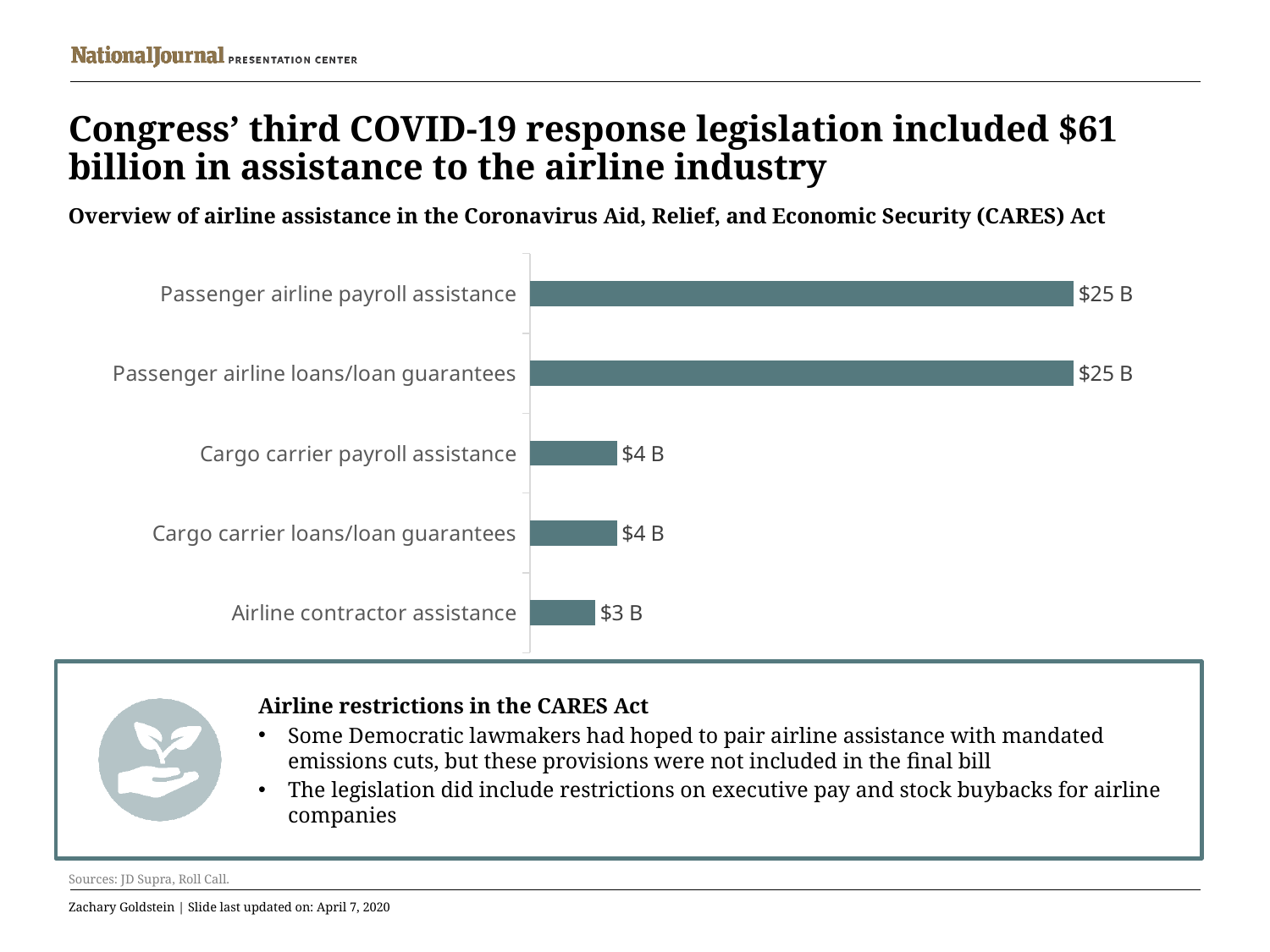
What is the value for Airline contractor assistance? $3 B Which category has the lowest value? Airline contractor assistance What kind of chart is shown on the slide? Bar chart What is the value for Cargo carrier payroll assistance? $4 B What is the subtitle of the chart? Overview of airline assistance in the Coronavirus Aid, Relief, and Economic Security (CARES) Act What is the value for Passenger airline loans/loan guarantees? $25 B What is the difference between Cargo carrier loans/loan guarantees and Airline contractor assistance? $1 B Which is larger, Cargo carrier payroll assistance or Airline contractor assistance? Cargo carrier payroll assistance What is the difference between Passenger airline payroll assistance and Cargo carrier payroll assistance? $21 B How many categories are shown in the chart? 5 What is the value for Passenger airline payroll assistance? $25 B Which is larger, Passenger airline loans/loan guarantees or Cargo carrier loans/loan guarantees? Passenger airline loans/loan guarantees